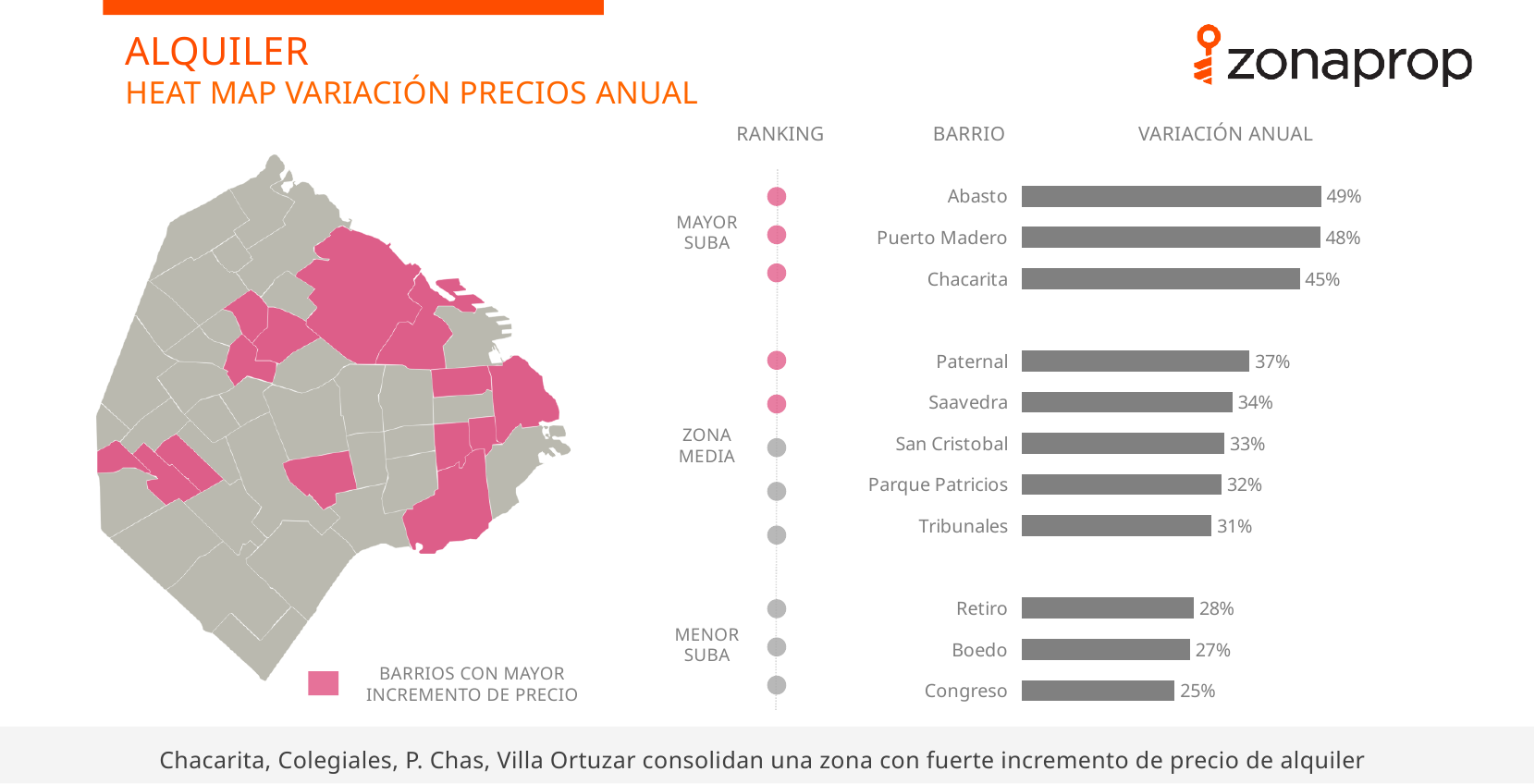
What is the annual variation shown for Abasto? 49% Which has a larger annual variation, Retiro or Tribunales? Tribunales What kind of chart shows the annual variation by barrio? Bar chart What is the annual variation shown for Congreso? 25% What is the annual variation shown for Saavedra? 34% How many barrios are listed in the bar chart? 11 Do the annual variation values rise or fall going down the list from Abasto to Congreso? Fall What is the annual variation shown for Puerto Madero? 48% Which barrio has the lowest annual variation in the bar chart? Congreso Which barrio has the highest annual variation in the bar chart? Abasto Which barrios are grouped under 'MAYOR SUBA' in the ranking? Abasto, Puerto Madero, Chacarita What is the difference between the annual variation for Chacarita and for Paternal? 8%